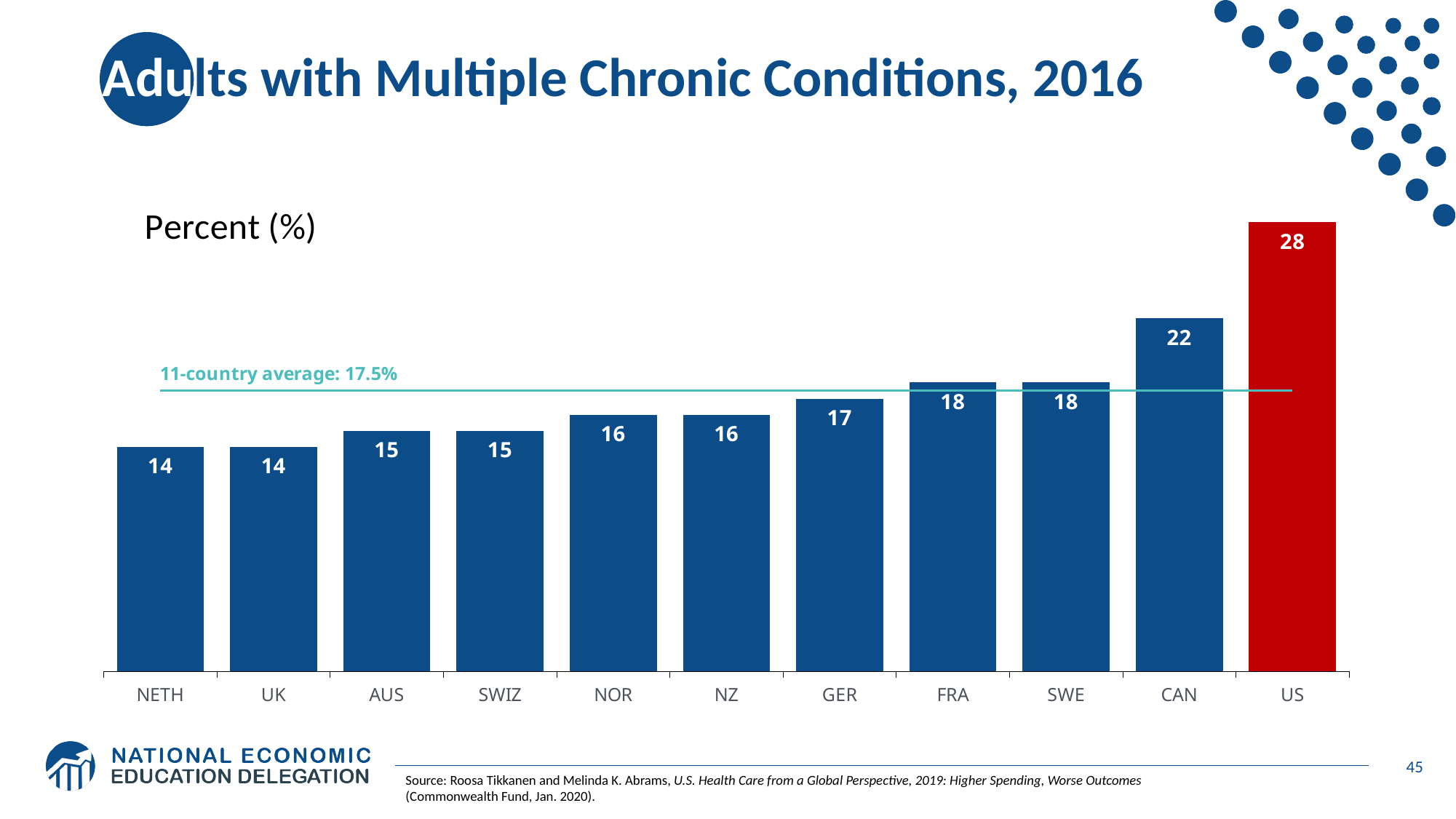
What is the difference between the values for FRA and NETH? 4 What is the difference between the values for the US and CAN? 6 Do the values rise or fall from left to right across the countries? rise Which country's bar is coloured red? US How many countries are shown on the chart? 11 Which is larger, the value for NOR or the value for SWE? SWE What kind of chart is shown on the slide? bar chart Which country has the highest value? US What is the value for CAN? 22 What is the value for the US? 28 What is the value for GER? 17 What is the 11-country average shown on the chart? 17.5%